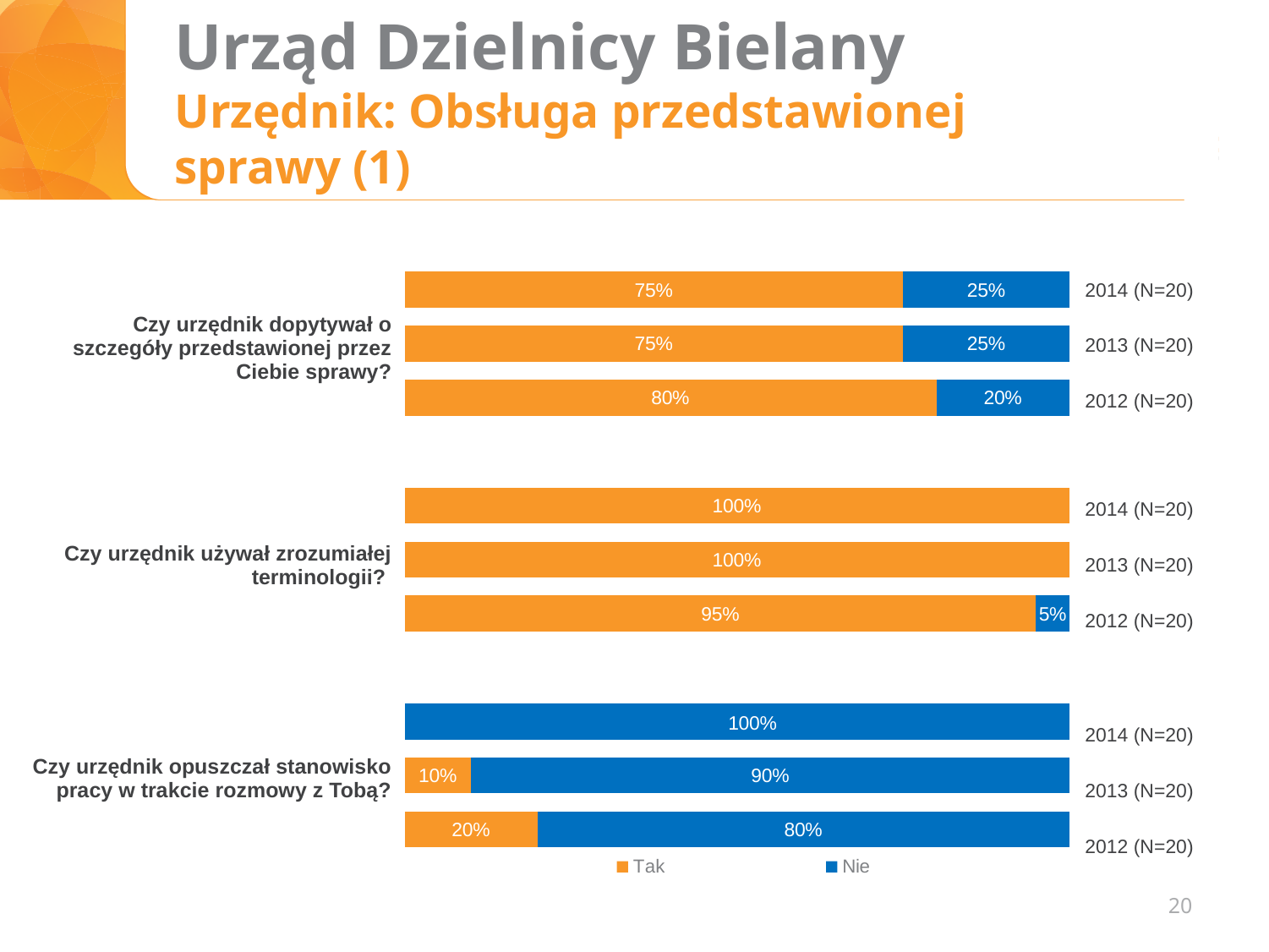
What kind of chart is shown on the slide? Stacked bar chart What share of respondents answered "Nie" in 2012 to "Czy urzędnik dopytywał o szczegóły przedstawionej przez Ciebie sprawy?"? 20% For "Czy urzędnik używał zrozumiałej terminologii?", in which year was the "Tak" share lowest? 2012 What is the sample size (N) shown for each year in the chart? N=20 What is the difference between the "Tak" share in 2012 and in 2014 for "Czy urzędnik dopytywał o szczegóły przedstawionej przez Ciebie sprawy?"? 5% What share of respondents answered "Tak" in 2012 to "Czy urzędnik używał zrozumiałej terminologii?"? 95% How many series does the legend list? 2 What share of respondents answered "Nie" in 2013 to "Czy urzędnik opuszczał stanowisko pracy w trakcie rozmowy z Tobą?"? 90% How does the "Nie" share for "Czy urzędnik opuszczał stanowisko pracy w trakcie rozmowy z Tobą?" change from 2012 to 2014? It rises For "Czy urzędnik opuszczał stanowisko pracy w trakcie rozmowy z Tobą?", which is larger: the "Nie" share in 2013 or in 2012? 2013 What share of respondents answered "Tak" in 2014 to "Czy urzędnik dopytywał o szczegóły przedstawionej przez Ciebie sprawy?"? 75% For "Czy urzędnik opuszczał stanowisko pracy w trakcie rozmowy z Tobą?", in which year was the "Tak" share highest? 2012